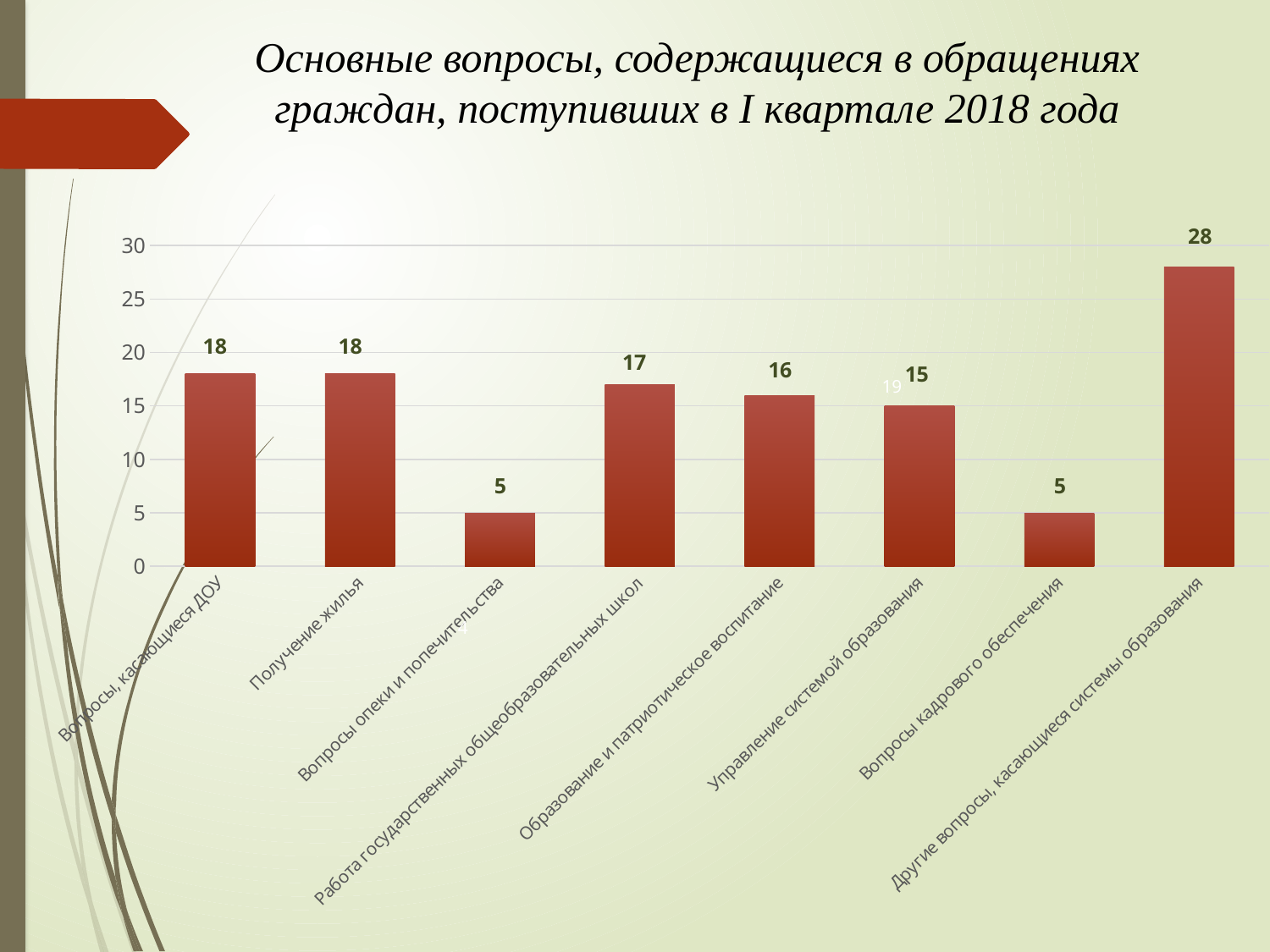
What value is shown for «Работа государственных общеобразовательных школ»? 17 What value is shown for «Управление системой образования»? 15 How many categories are shown in the chart? 8 Which category has the highest value? Другие вопросы, касающиеся системы образования Which is larger: the value for «Образование и патриотическое воспитание» or for «Управление системой образования»? Образование и патриотическое воспитание What is the title of the slide? Основные вопросы, содержащиеся в обращениях граждан, поступивших в I квартале 2018 года Is the value for «Другие вопросы, касающиеся системы образования» greater or less than 25? greater What value is shown for «Вопросы кадрового обеспечения»? 5 What kind of chart is shown on the slide? bar chart What value is shown for «Получение жилья»? 18 What is the difference between the values for «Другие вопросы, касающиеся системы образования» and «Вопросы, касающиеся ДОУ»? 10 What is the difference between the values for «Образование и патриотическое воспитание» and «Вопросы опеки и попечительства»? 11